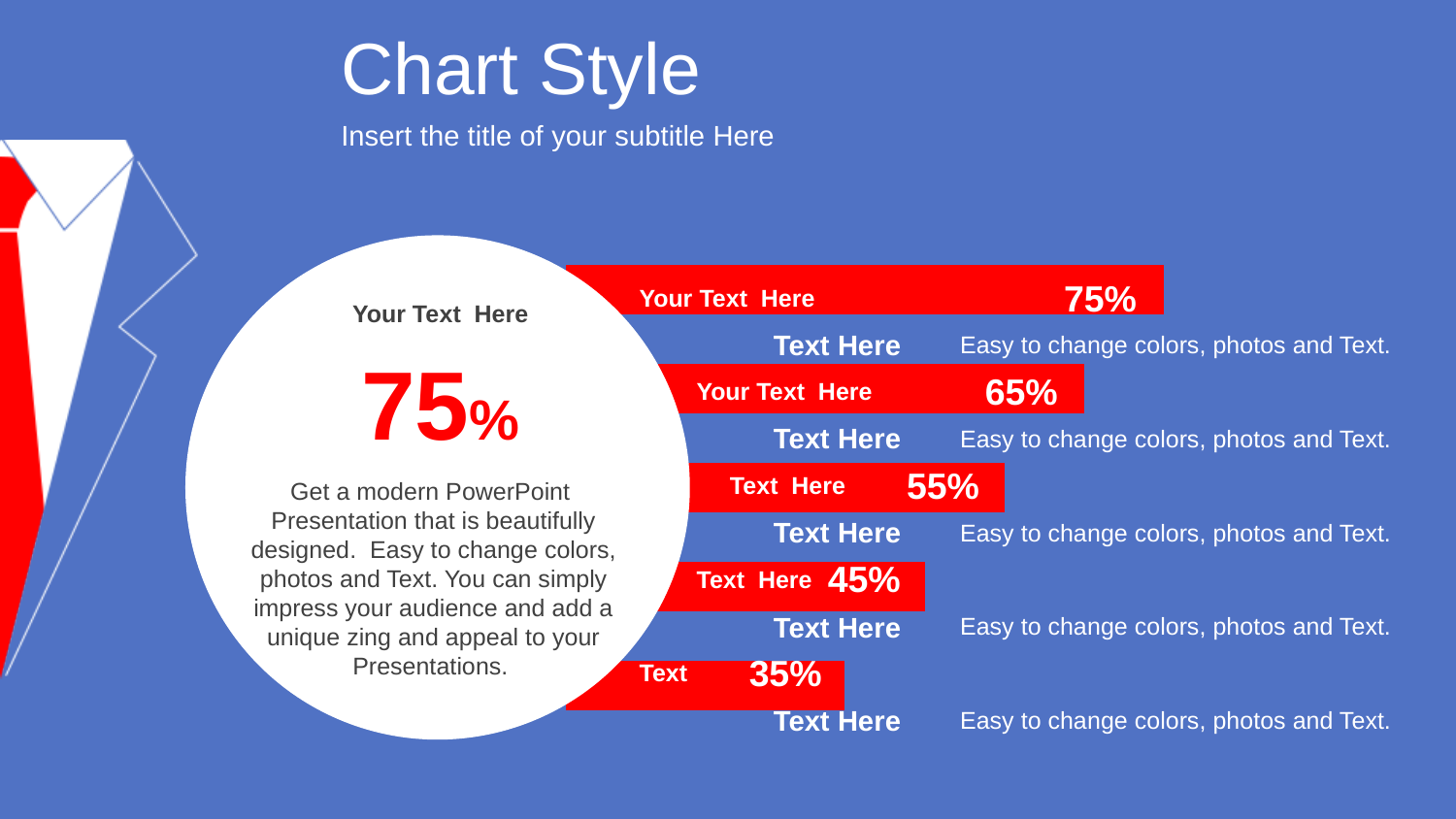
What kind of chart is shown on the slide? bar chart What value is printed on the middle (third) bar of the chart? 55% What value is printed on the top bar of the chart? 75% Which is larger, the value of the second bar from the top or the value of the fourth bar from the top? the second bar (65%) What value is printed on the fourth bar from the top of the chart? 45% What value is printed on the bottom bar of the chart? 35% How many bars does the chart on the slide have? 5 Which bar has the highest value in the chart? the top bar (75%) Which bar has the lowest value in the chart? the bottom bar (35%) Do the bar values increase or decrease going from the top bar to the bottom bar? decrease What is the difference between the top bar's value and the bottom bar's value? 40% What value is printed on the second bar from the top of the chart? 65%